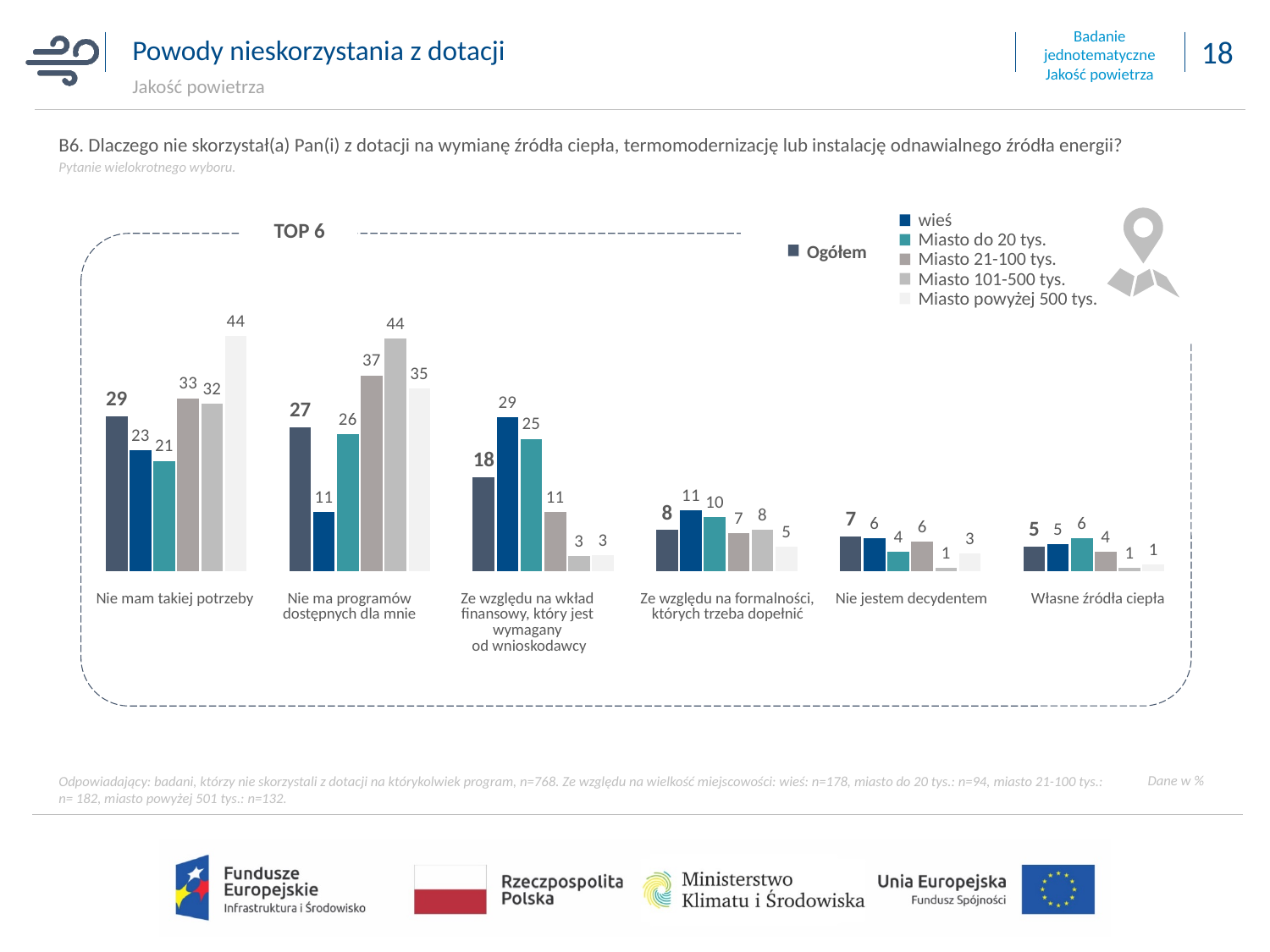
For "Nie ma programów dostępnych dla mnie", which is larger: the value for "wieś" or for "Miasto do 20 tys."? Miasto do 20 tys. What is the value for "Miasto powyżej 500 tys." in the category "Nie ma programów dostępnych dla mnie"? 35 What is the difference between the "Miasto powyżej 500 tys." value and the "wieś" value for "Nie mam takiej potrzeby"? 21 How many series does the legend list? 6 Which category has the highest Ogółem value? Nie mam takiej potrzeby Do the Ogółem values rise or fall from left to right across the categories? fall What is the Ogółem value for "Nie mam takiej potrzeby"? 29 What is the value for "Miasto 101-500 tys." in the category "Nie jestem decydentem"? 1 Which category has the lowest Ogółem value? Własne źródła ciepła What kind of chart is shown on the slide? bar chart How many categories are shown on the x axis of the chart? 6 What is the value for "wieś" in the category "Ze względu na wkład finansowy, który jest wymagany od wnioskodawcy"? 29